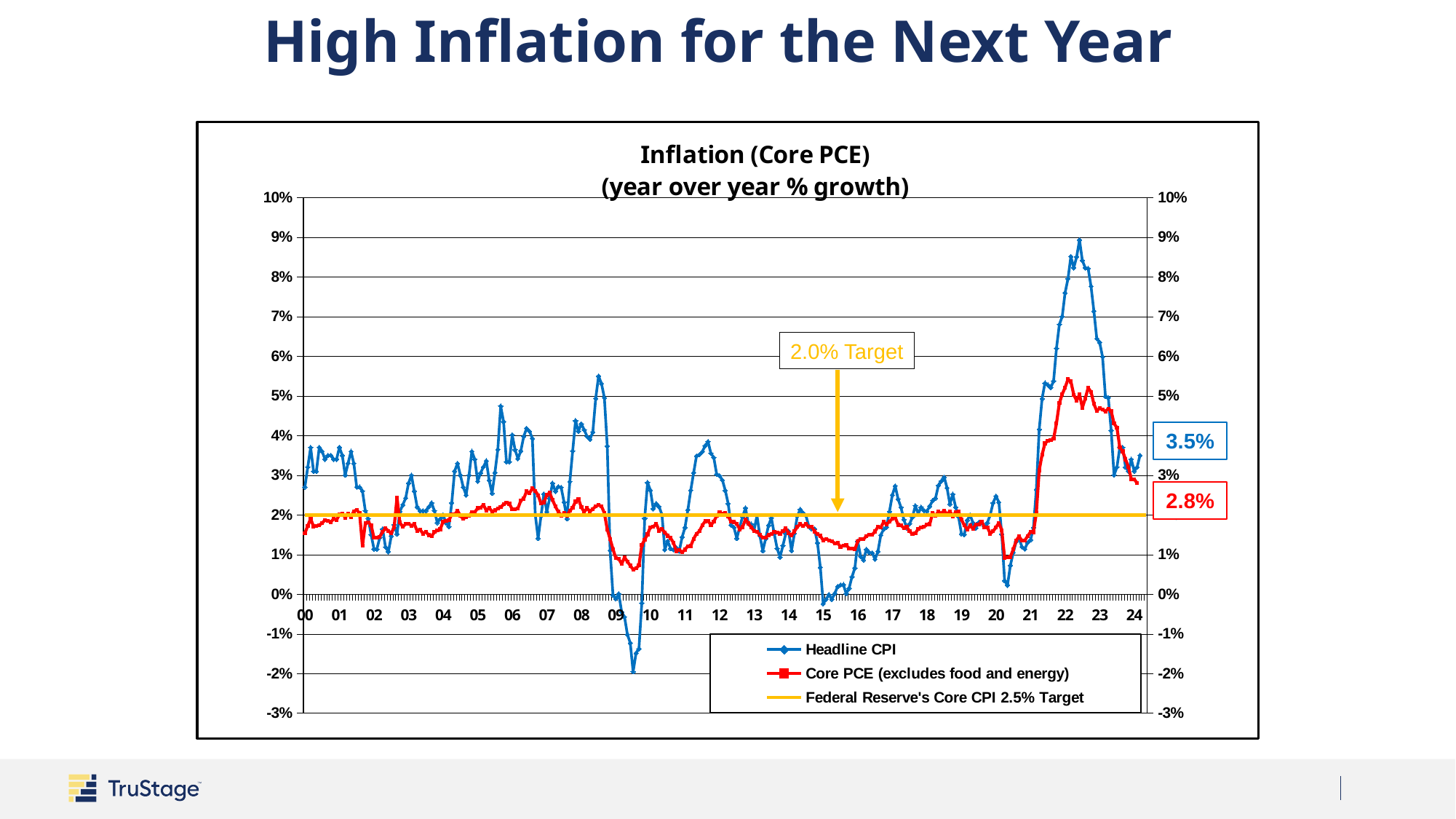
Is the peak value of Core PCE in 2022 greater or less than 5%? greater What is the latest labelled value for Core PCE? 2.8% What kind of chart is shown on the slide? line chart Which series reaches the highest value on the chart? Headline CPI What is the difference between the latest labelled Headline CPI value and the latest labelled Core PCE value? 0.7% Is the peak value of Headline CPI in 2022 greater or less than 8%? greater What value does the annotation give for the target line? 2.0% Target What is the latest labelled value for Headline CPI? 3.5% Which is larger at the end of the chart, the labelled Headline CPI value or the labelled Core PCE value? Headline CPI Is the lowest value of Headline CPI in 2009 greater or less than -1%? less How many series does the legend list? 3 What is the legend label for the yellow line? Federal Reserve's Core CPI 2.5% Target